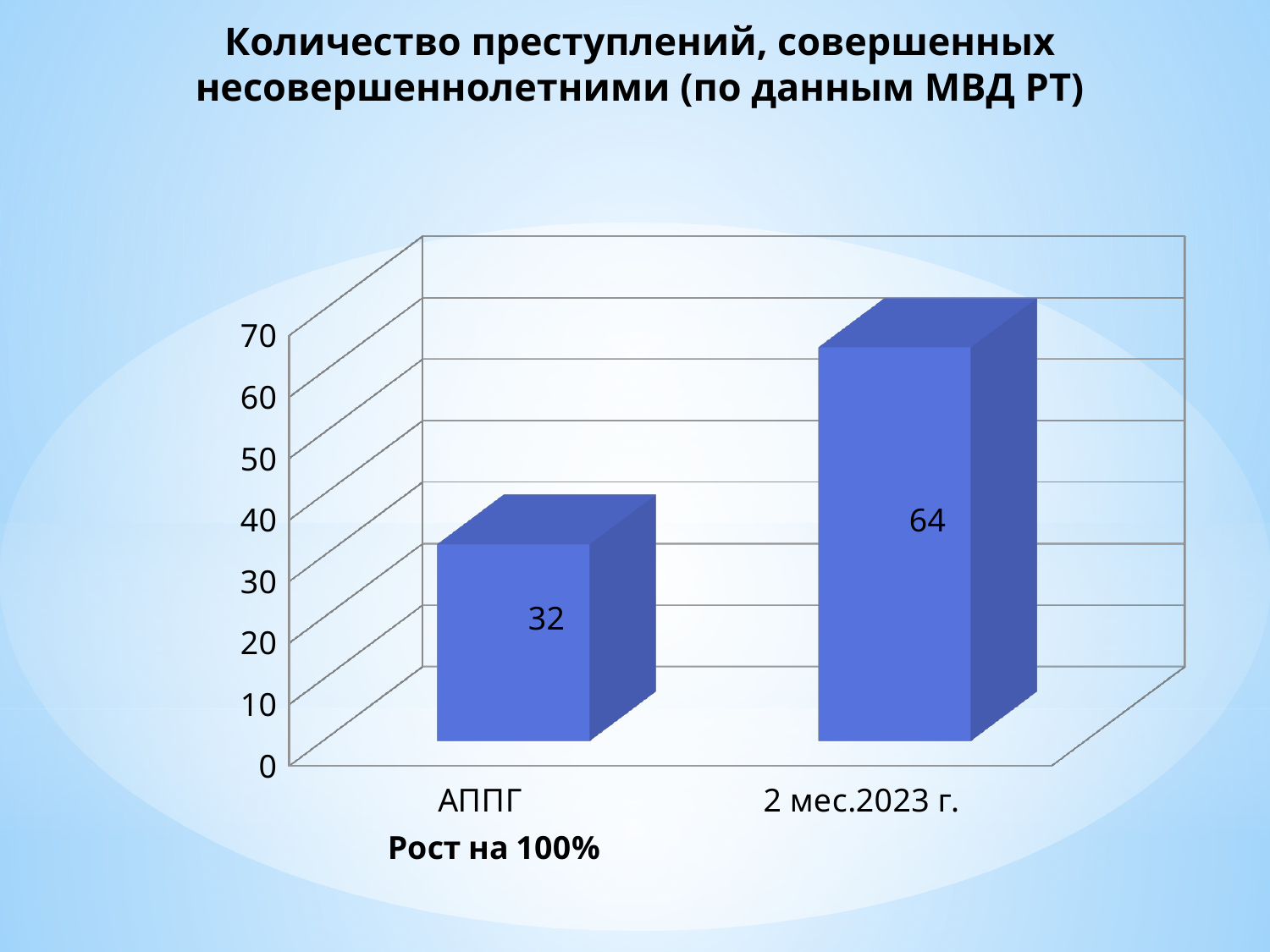
Which category has the highest value? 2 мес.2023 г. What is the value for 2 мес.2023 г.? 64 Is the value for АППГ greater or less than 40? less What is the title of the chart? Количество преступлений, совершенных несовершеннолетними (по данным МВД РТ) What is the difference between the values for 2 мес.2023 г. and АППГ? 32 Do the values rise or fall from АППГ to 2 мес.2023 г.? rise Which is larger, the value for АППГ or the value for 2 мес.2023 г.? 2 мес.2023 г. How many categories are shown on the x axis? 2 Which category has the lowest value? АППГ What is the value for АППГ? 32 What kind of chart is shown on the slide? bar chart Is the value for 2 мес.2023 г. greater or less than 50? greater